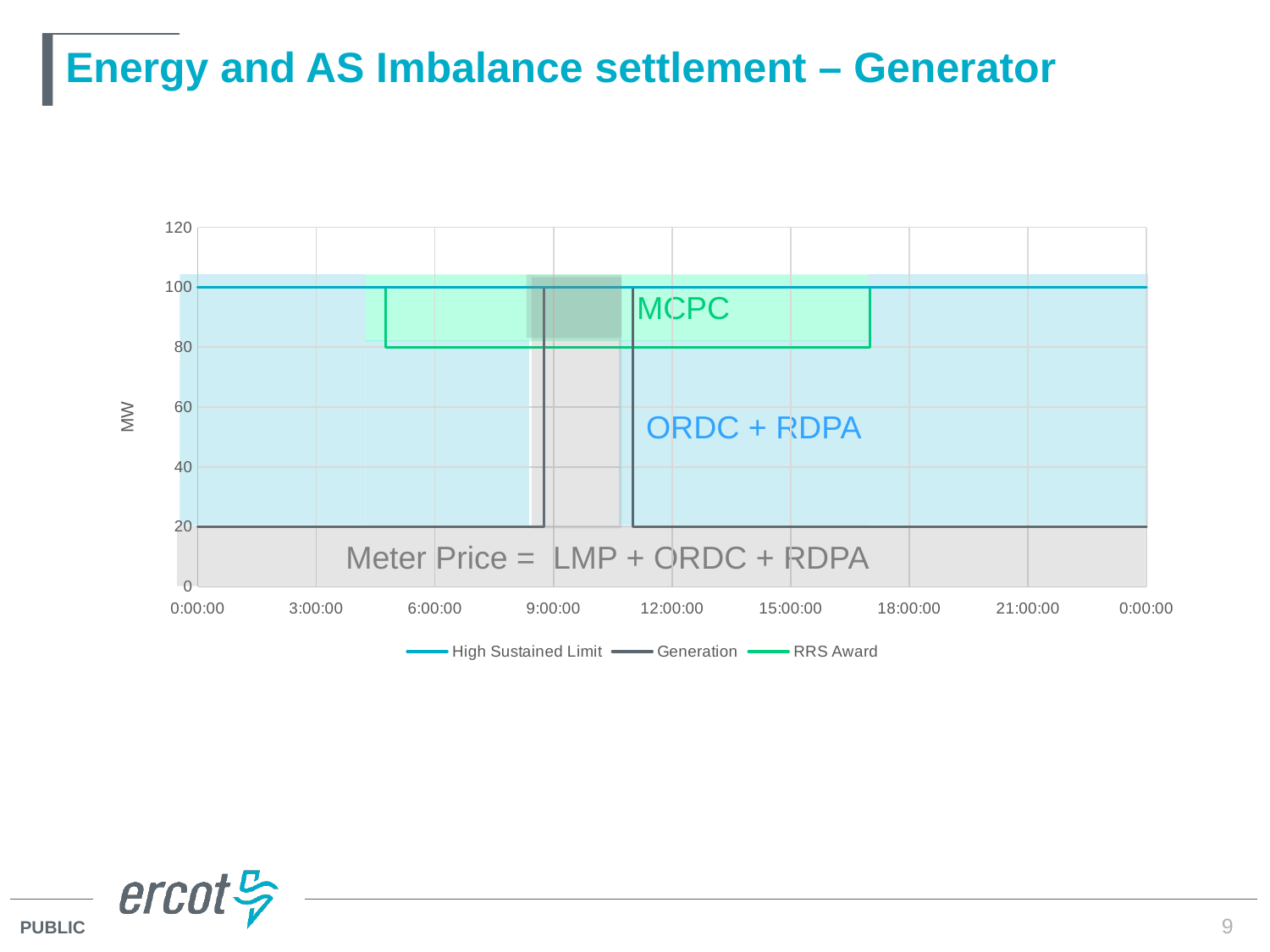
Which series has the lowest value at 15:00:00? Generation What is the Generation value at 3:00:00 in MW? 20 Is the Generation value at 10:00:00 greater or less than 60? greater At 12:00:00, which is larger, the High Sustained Limit or the RRS Award? High Sustained Limit What is the RRS Award value at 12:00:00 in MW? 80 What is the value of the High Sustained Limit series in MW? 100 What is the label on the y axis? MW How many series does the legend list? 3 What formula for Meter Price is written inside the chart? Meter Price = LMP + ORDC + RDPA What type of chart is shown on the slide? line chart Which series has the highest value at 15:00:00? High Sustained Limit At 12:00:00, what is the difference between the High Sustained Limit and the RRS Award in MW? 20